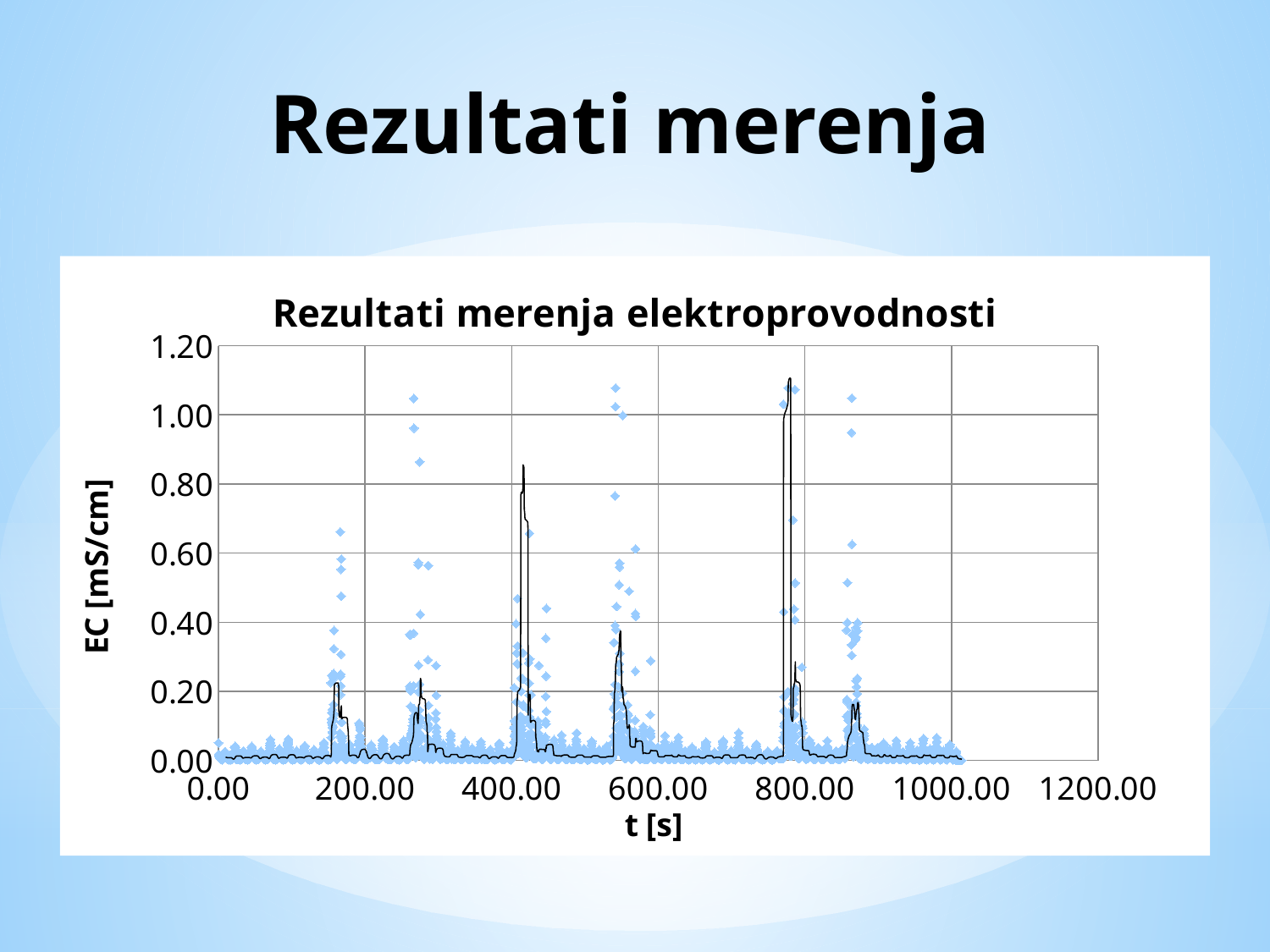
Is the highest scatter point near t = 270 s greater or less than 1.00? greater Is the peak of the black line near t = 550 s greater or less than 0.60? less What is the title of the chart? Rezultati merenja elektroprovodnosti What is the label of the vertical axis of the chart? EC [mS/cm] Is the peak of the black line near t = 400 s greater or less than 1.00? less What kind of chart is shown on the slide? scatter chart